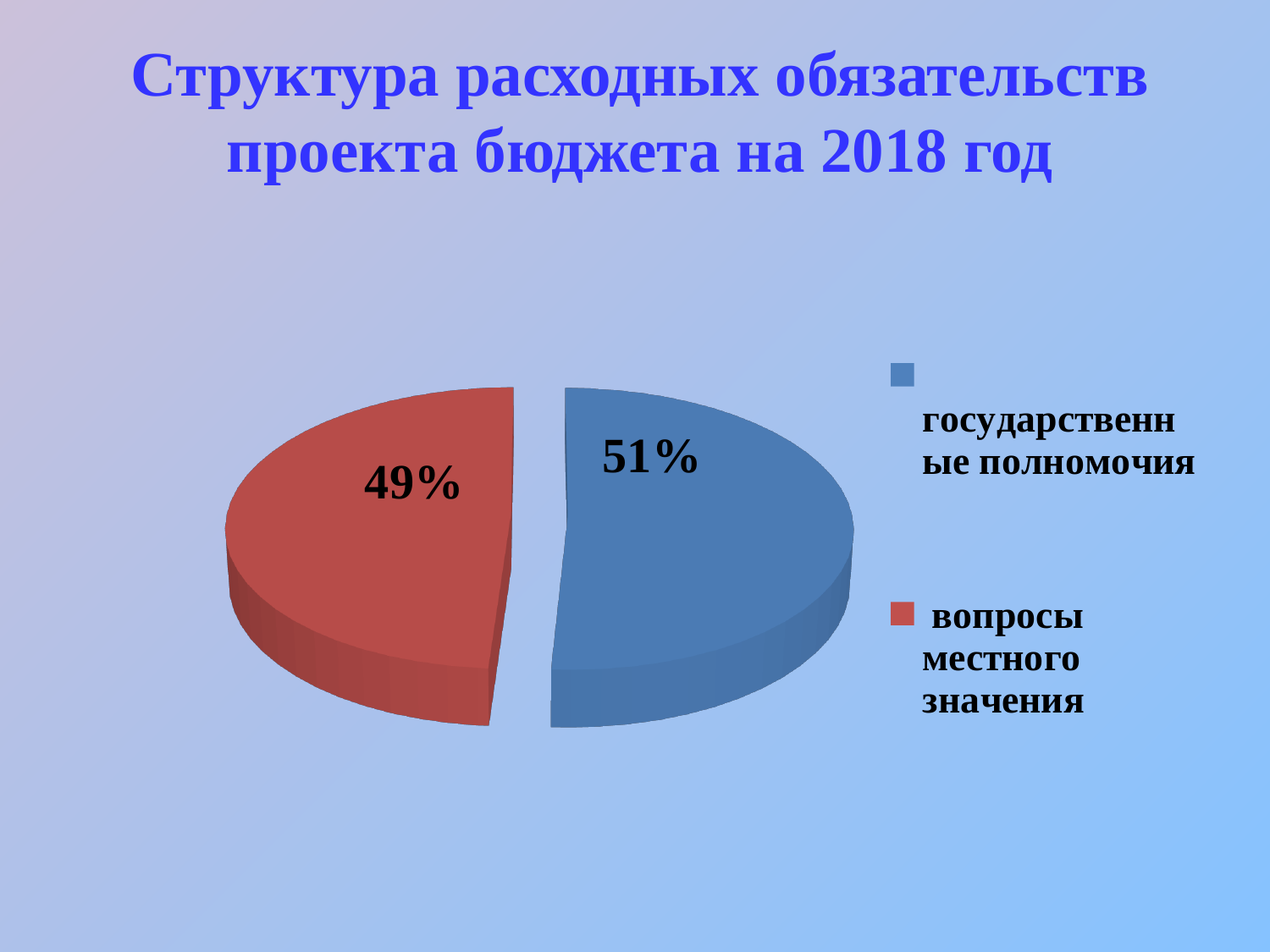
How many slices does the pie chart have? 2 What colour is the slice for "вопросы местного значения"? red Which category has the smallest slice of the pie? вопросы местного значения What share of the pie does "государственные полномочия" have? 51% Which is larger: the slice for "государственные полномочия" or the slice for "вопросы местного значения"? государственные полномочия What is the title of the slide? Структура расходных обязательств проекта бюджета на 2018 год Is the share for "вопросы местного значения" greater or less than 50%? less What is the difference in percentage points between "государственные полномочия" and "вопросы местного значения"? 2% Which category has the largest slice of the pie? государственные полномочия How many entries does the legend list? 2 What kind of chart is shown on the slide? pie chart What share of the pie does "вопросы местного значения" have? 49%